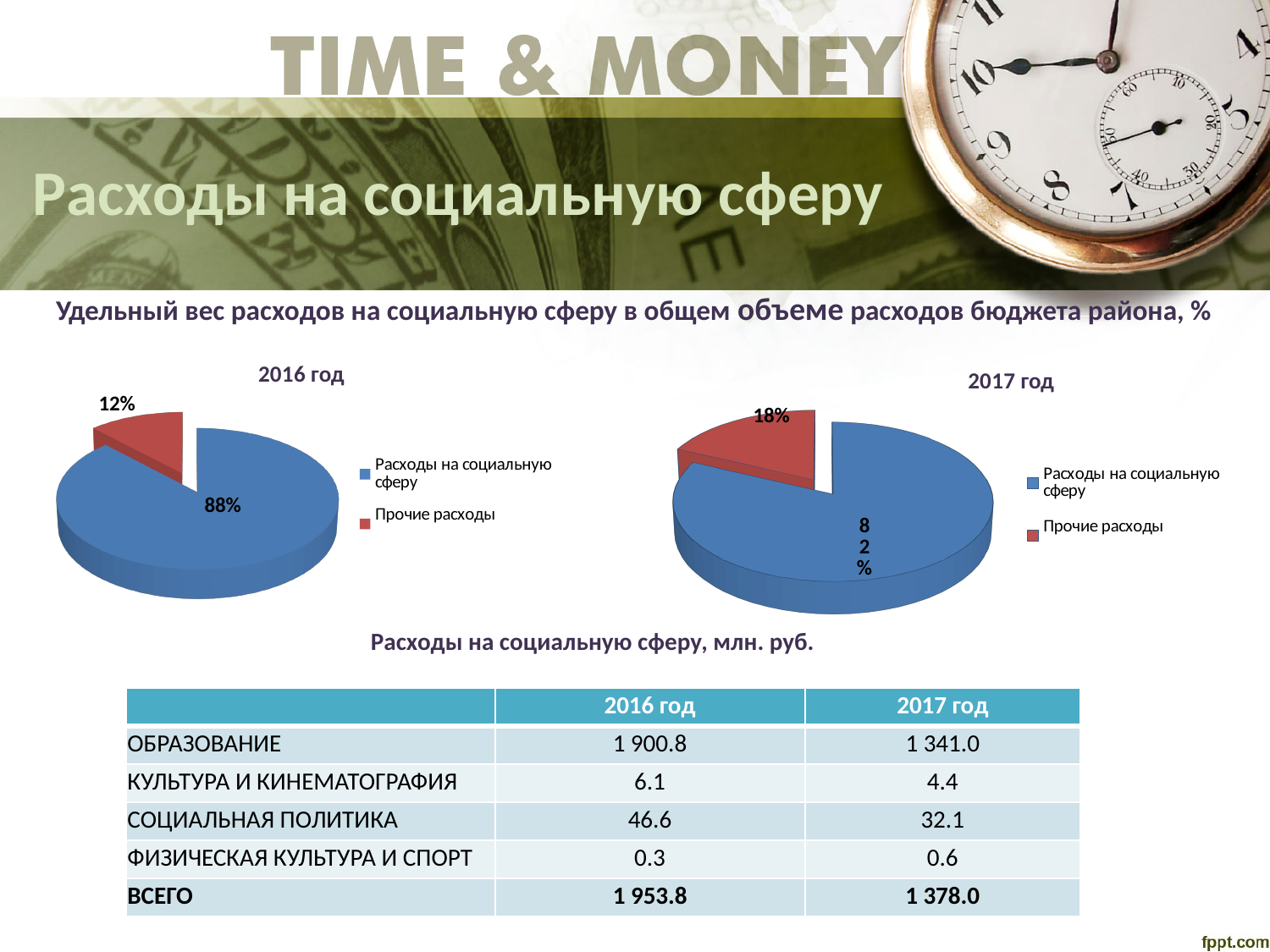
How many entries does the legend of the "2016 год" chart list? 2 In the "2016 год" pie chart, what share is shown for Расходы на социальную сферу? 88% In the "2016 год" pie chart, what share is shown for Прочие расходы? 12% In the "2016 год" pie chart, what is the difference in percentage points between Расходы на социальную сферу and Прочие расходы? 76 In the "2017 год" pie chart, what colour is the slice for Прочие расходы? Red In the "2017 год" pie chart, what share is shown for Расходы на социальную сферу? 82% What type of chart is used for "2016 год"? Pie chart How many slices does the "2017 год" pie chart have? 2 In the "2017 год" pie chart, which category has the smallest slice? Прочие расходы Is the share of Прочие расходы larger in the "2016 год" chart or the "2017 год" chart? 2017 год In the "2017 год" pie chart, what share is shown for Прочие расходы? 18% In the "2016 год" pie chart, which category has the largest slice? Расходы на социальную сферу